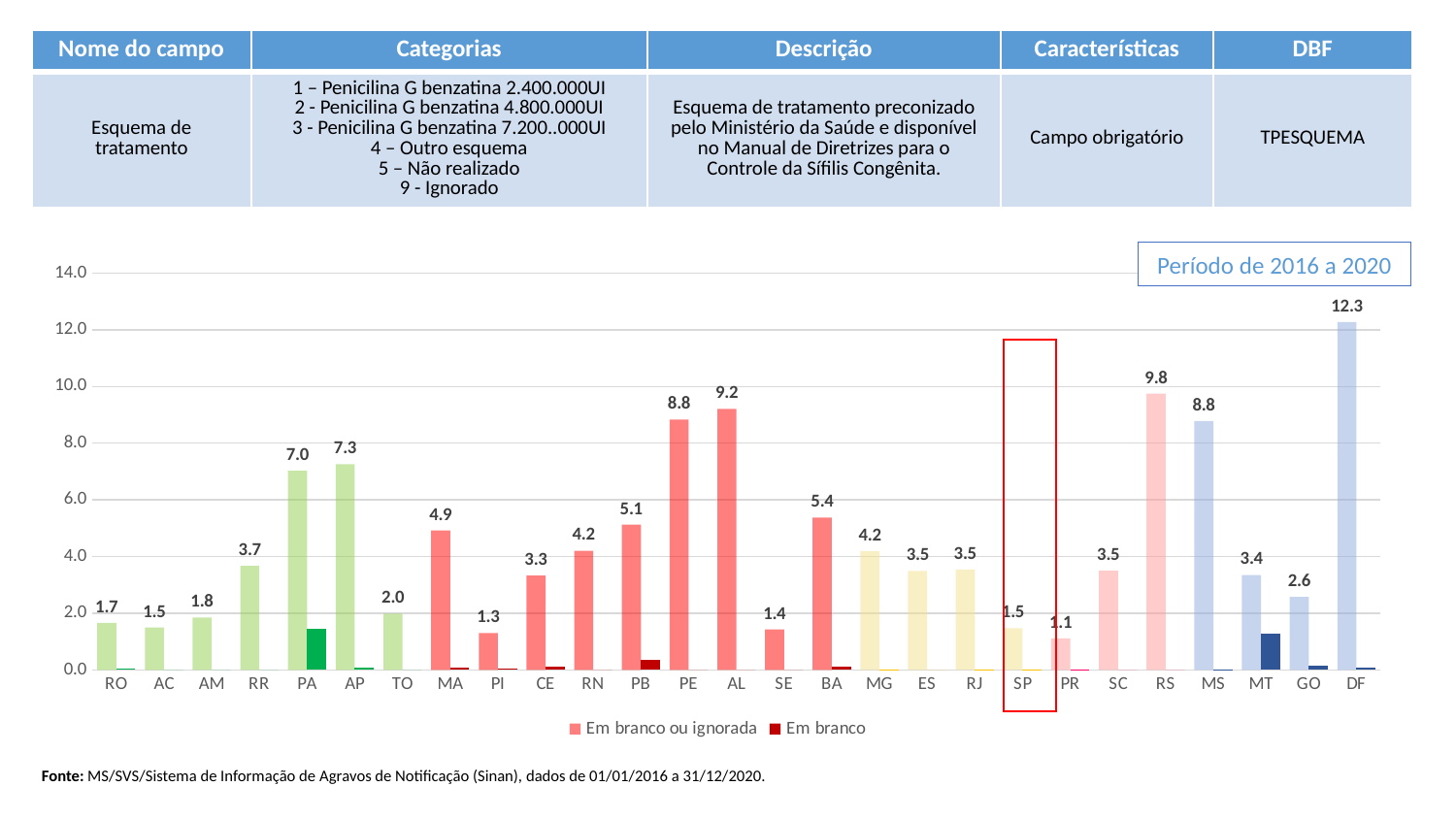
Is the 'Em branco' value for PA greater or less than 2.0? less What is the value of 'Em branco ou ignorada' for RS? 9.8 What period does the chart cover, according to the label on the slide? Período de 2016 a 2020 What is the difference between the 'Em branco ou ignorada' values for AL and PE? 0.4 Which state has the lowest 'Em branco ou ignorada' value? PR What is the value of 'Em branco ou ignorada' for DF? 12.3 What type of chart is shown on the slide? Bar chart Which state has the highest 'Em branco ou ignorada' value? DF What is the value of 'Em branco ou ignorada' for SP? 1.5 How many series does the chart legend list? 2 How many states are shown on the x axis of the chart? 27 Which has a larger 'Em branco ou ignorada' value, PA or MA? PA